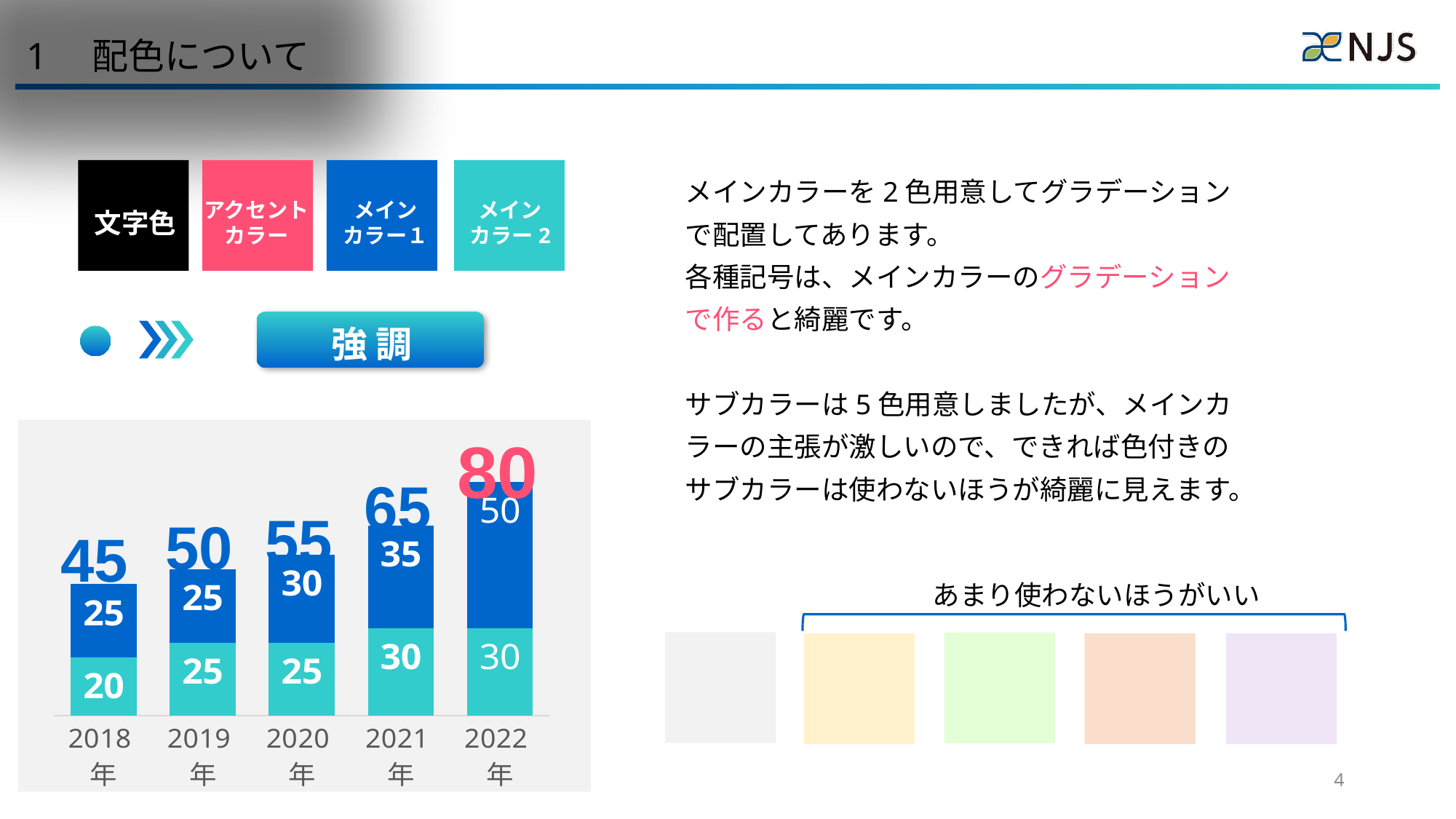
Which year has the highest total? 2022年 Which is larger, the total for 2019年 or the total for 2020年? 2020年 Which year has the lowest total? 2018年 What is the difference between the top (blue) segment and the bottom (teal) segment of the 2020年 bar? 5 What is the total shown above the bar for 2022年? 80 Do the bar totals rise or fall from 2018年 to 2022年? Rise What is the value of the bottom (teal) segment of the 2018年 bar? 20 What is the value of the top (blue) segment of the 2021年 bar? 35 What is the difference between the totals for 2022年 and 2021年? 15 How many years are shown on the x axis of the chart? 5 What kind of chart is shown on the slide? Stacked bar chart What is the value of the top (blue) segment of the 2022年 bar? 50